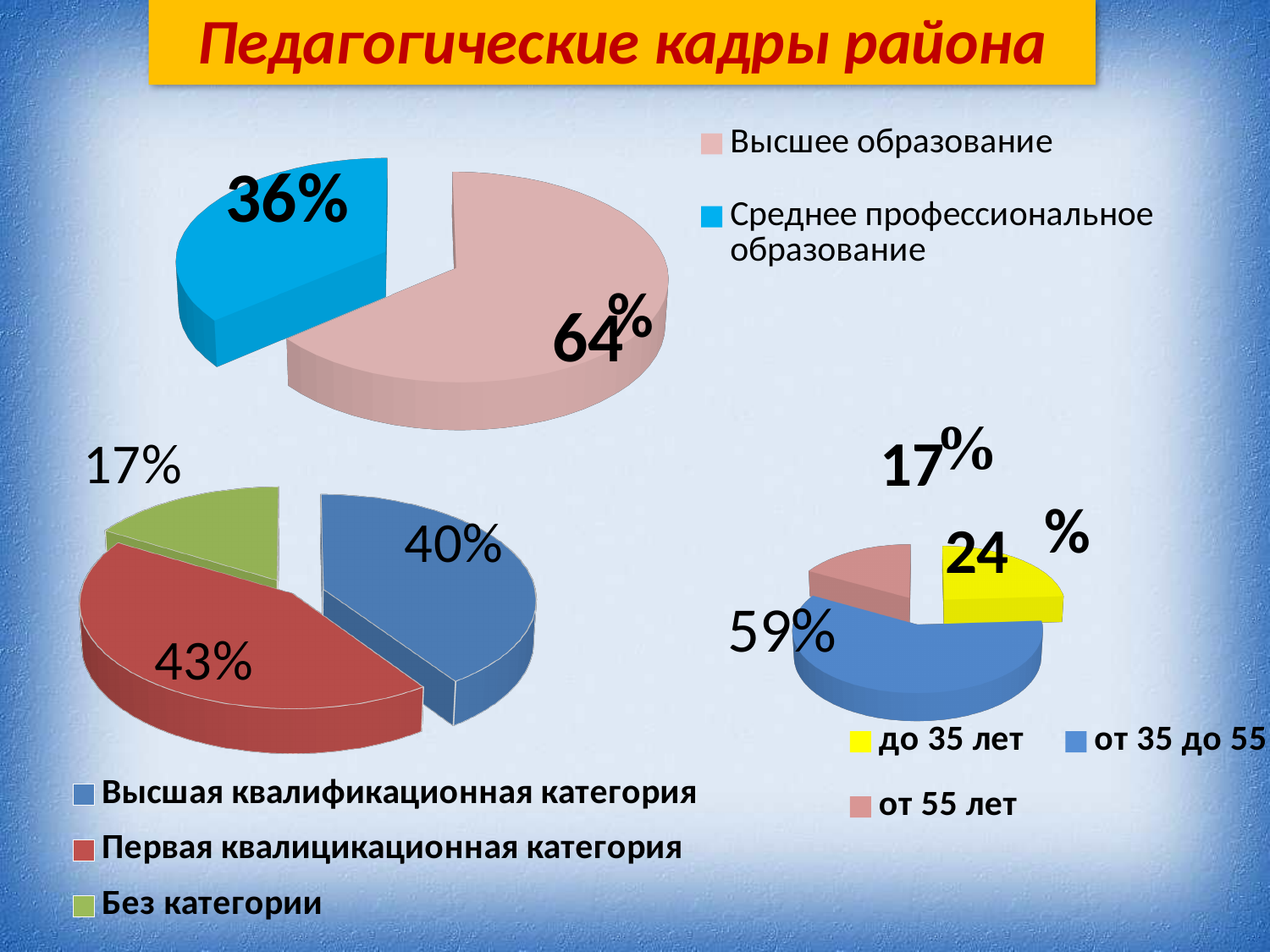
On the bottom-right pie chart, how many age groups are shown? 3 On the top pie chart, what is the difference between the share with higher education and the share with secondary professional education? 28% On the bottom-left pie chart, what share of teachers have the first qualification category (Первая квалификационная категория)? 43% On the top pie chart, how many series does the legend list? 2 On the top pie chart, what share of teachers have secondary professional education (Среднее профессиональное образование)? 36% On the bottom-right pie chart, which age group has the largest share? от 35 до 55 On the bottom-left pie chart, which is larger: the share with the highest qualification category or the share with the first qualification category? Первая квалификационная категория On the bottom-right pie chart, what share of teachers are under 35 years old (до 35 лет)? 24% What type of charts are shown on the slide? Pie charts On the bottom-left pie chart, which category has the smallest share? Без категории On the bottom-left pie chart, what share of teachers have no category (Без категории)? 17% On the top pie chart, what share of teachers have higher education (Высшее образование)? 64%